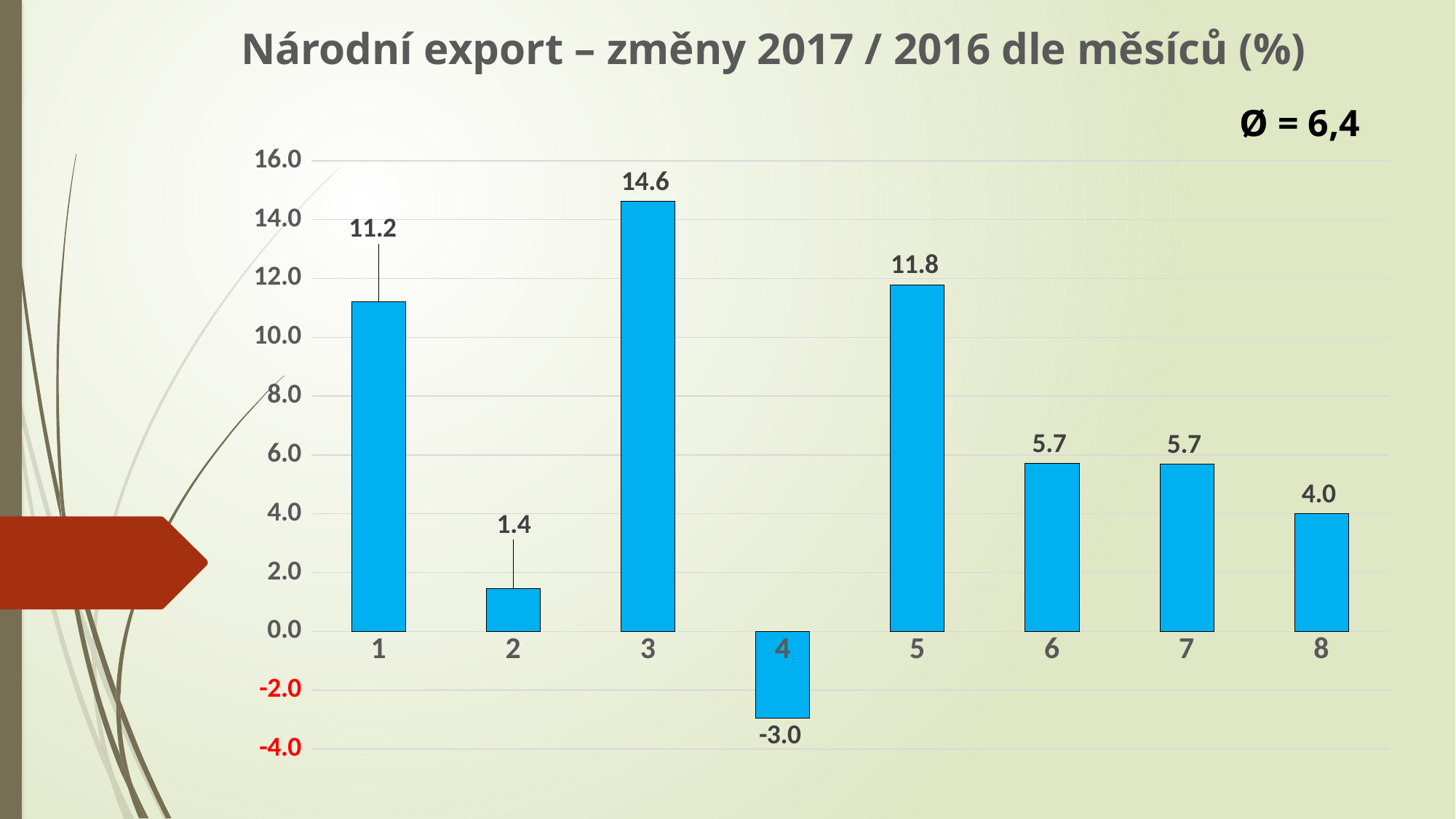
What kind of chart is shown on the slide? bar chart What is the value for month 3? 14.6 What is the value for month 4? -3.0 Which month has the highest value? 3 What is the difference between the values for month 3 and month 1? 3.4 Which month has the lowest value? 4 What is the difference between the values for month 5 and month 8? 7.8 Which is larger, the value for month 1 or the value for month 5? month 5 How many months (bars) are shown in the chart? 8 Is the value for month 2 greater or less than 2.0? less What average value (Ø) is stated on the slide? 6,4 What is the value for month 8? 4.0